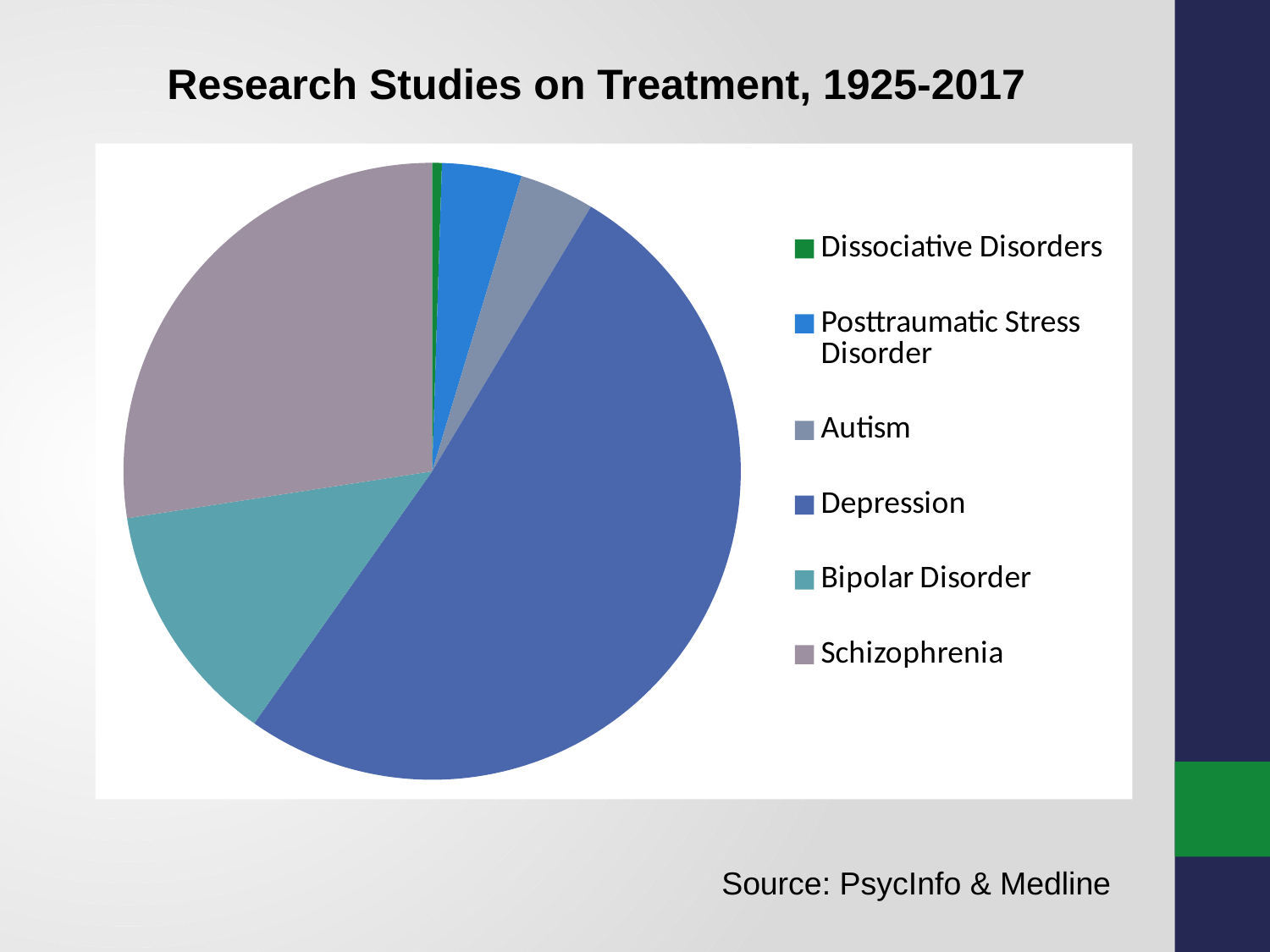
Which slice is larger, Schizophrenia or Bipolar Disorder? Schizophrenia Which slice is larger, Autism or Dissociative Disorders? Autism Which slice is larger, Depression or Schizophrenia? Depression Which category has the second-largest slice of the pie chart? Schizophrenia Which category has the largest slice of the pie chart? Depression How many categories (slices) does the pie chart have? 6 What is the title of the chart on the slide? Research Studies on Treatment, 1925-2017 What colour is the Dissociative Disorders slice in the legend? Green Which category has the smallest slice of the pie chart? Dissociative Disorders What kind of chart is shown on the slide? Pie chart